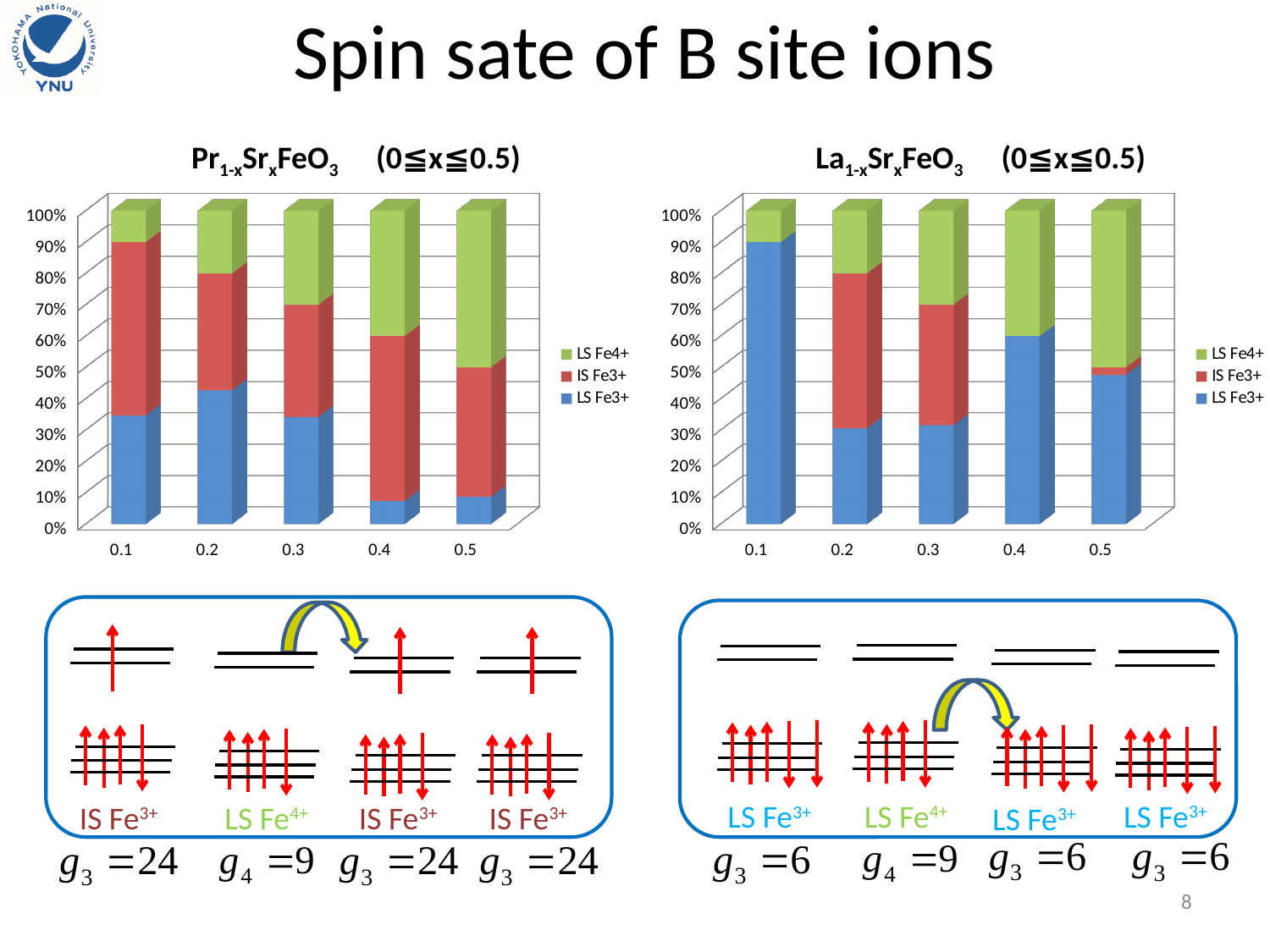
Which series is shown in green in the legend of the La1-xSrxFeO3 chart on the right? LS Fe4+ In the Pr1-xSrxFeO3 chart on the left, does the LS Fe4+ share rise or fall as x increases from 0.1 to 0.5? rise In the La1-xSrxFeO3 chart on the right, is the LS Fe3+ share at x = 0.1 greater or less than 80%? greater In the Pr1-xSrxFeO3 chart on the left, which x value has the largest LS Fe4+ share? 0.5 How many x-axis categories does the Pr1-xSrxFeO3 chart on the left have? 5 What type of chart is the Pr1-xSrxFeO3 chart on the left? stacked bar chart How many series does the legend of the La1-xSrxFeO3 chart on the right list? 3 In the Pr1-xSrxFeO3 chart on the left, is the LS Fe3+ share larger at x = 0.2 or at x = 0.4? 0.2 In the La1-xSrxFeO3 chart on the right, which x value has the largest LS Fe3+ share? 0.1 In the La1-xSrxFeO3 chart on the right, is the LS Fe3+ share larger at x = 0.1 or at x = 0.2? 0.1 In the La1-xSrxFeO3 chart on the right, is the LS Fe3+ share at x = 0.4 greater or less than 50%? greater In the Pr1-xSrxFeO3 chart on the left, is the LS Fe3+ share at x = 0.2 greater or less than 30%? greater